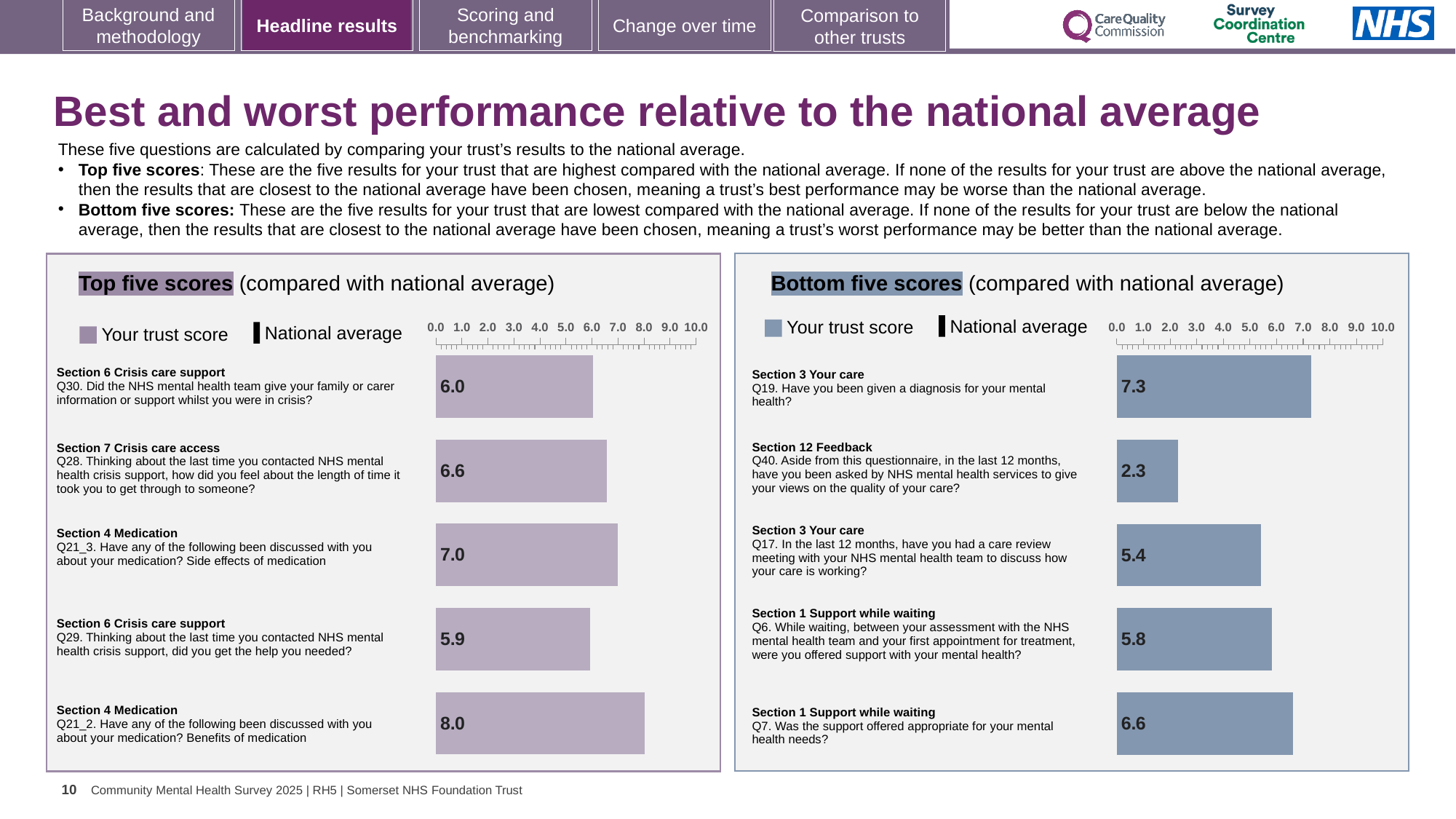
In the Bottom five scores chart, is the value for Q17 greater or less than 5.0? greater In the Bottom five scores chart, which has the larger trust score, Q19 or Q7? Q19 In the Bottom five scores chart, what is the trust score for Q40 (asked for views on quality of care)? 2.3 In the Top five scores chart, what is the difference between the scores for Q21_2 and Q29? 2.1 In the Top five scores chart, which question has the highest trust score? Q21_2 (8.0) In the Top five scores chart, which question has the lowest trust score? Q29 (5.9) How many bars are shown in the Top five scores chart? 5 What kind of chart is the Top five scores chart? Bar chart How many series does the legend of the Bottom five scores chart list? 2 In the Top five scores chart, what is the trust score for Q28 (length of time to get through to crisis support)? 6.6 In the Top five scores chart, what is the trust score for Q21_2 (benefits of medication)? 8.0 In the Bottom five scores chart, which question has the lowest trust score? Q40 (2.3)